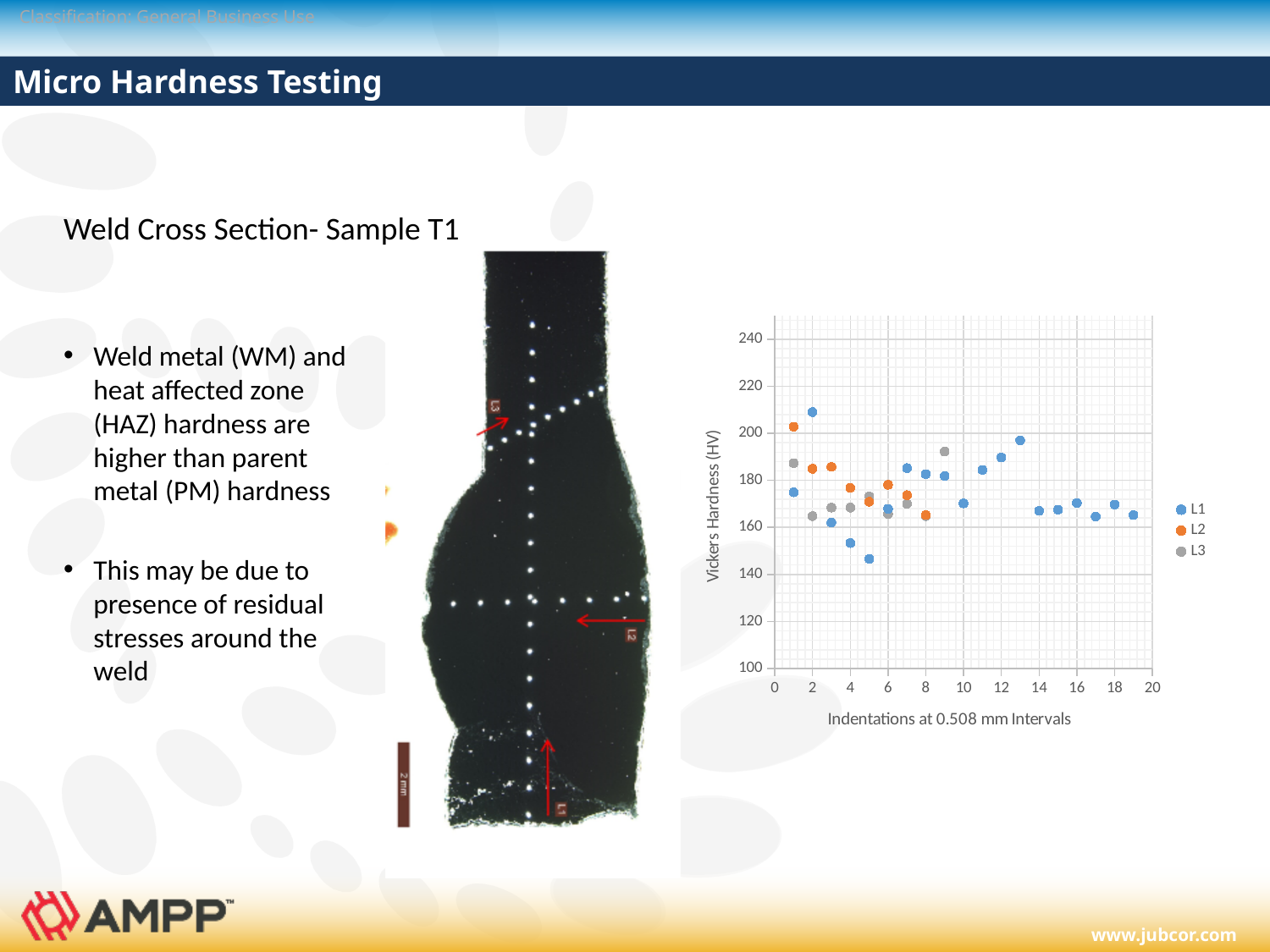
Is the L1 value at indentation 5 greater or less than 160? less Is the L1 value at indentation 2 greater or less than 200? greater Is the L1 value at indentation 13 greater or less than 180? greater What are the series names listed in the chart legend? L1, L2, L3 What is the title of the vertical axis of the chart? Vickers Hardness (HV) Which is larger: the L1 value at indentation 2 or the L1 value at indentation 5? L1 at indentation 2 How many series does the legend of the chart list? 3 How many points are plotted for series L2? 8 Which series contains the lowest plotted point on the chart? L1 What kind of chart is shown on the slide? scatter chart